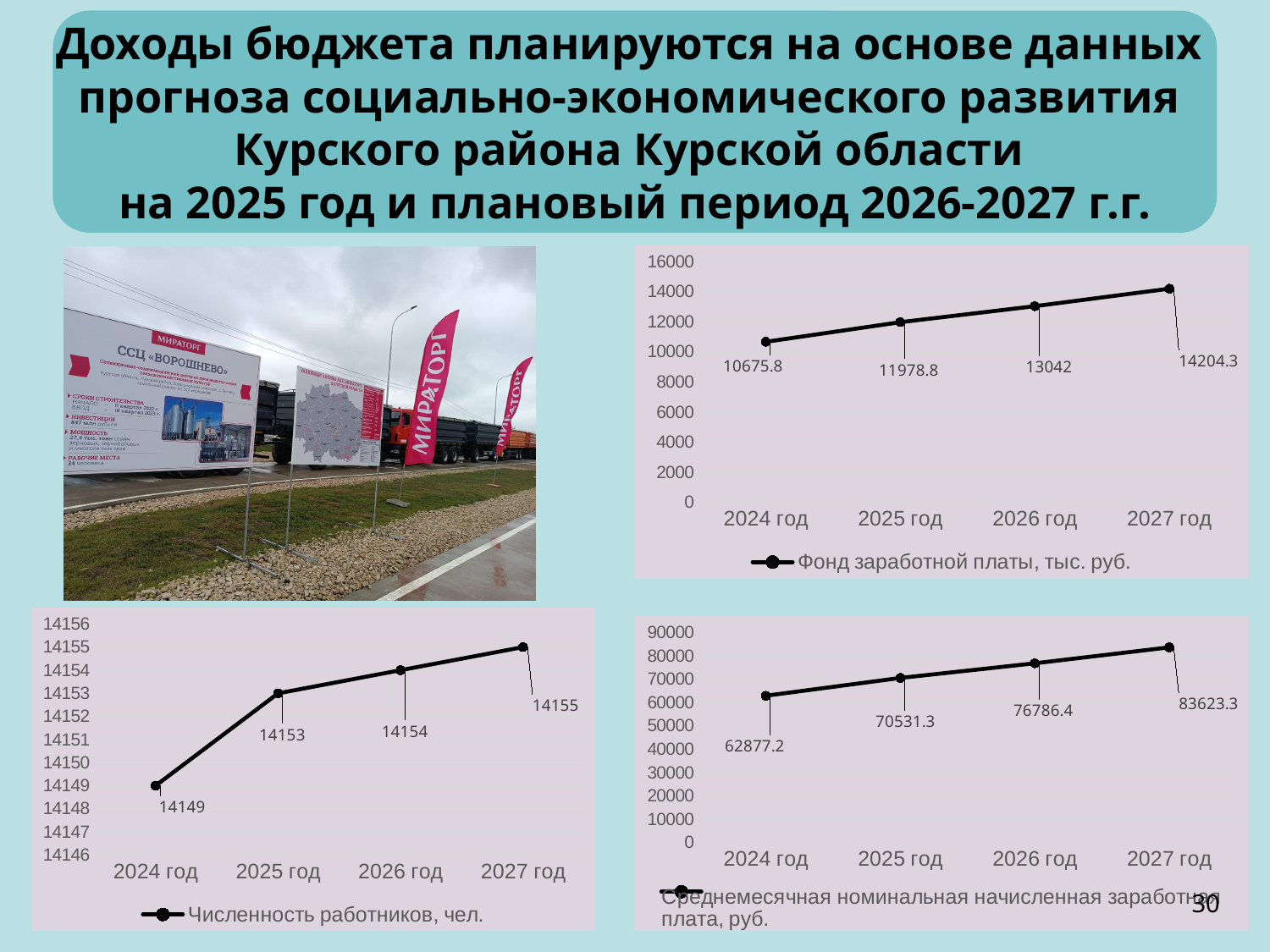
In the bottom-left chart (Численность работников, чел.), how many data points are plotted? 4 In the top-right chart (Фонд заработной платы, тыс. руб.), which year has the lowest value? 2024 год In the bottom-right chart (Среднемесячная номинальная начисленная заработная плата, руб.), what is the value for 2026 год? 76786.4 In the bottom-left chart (Численность работников, чел.), how much higher is the 2027 год value than the 2024 год value? 6 In the top-right chart (Фонд заработной платы, тыс. руб.), what is the value for 2024 год? 10675.8 In the top-right chart (Фонд заработной платы, тыс. руб.), what is the difference between the 2026 год and 2025 год values? 1063.2 In the bottom-right chart (Среднемесячная номинальная начисленная заработная плата, руб.), do the values rise or fall from 2024 год to 2027 год? rise In the bottom-left chart (Численность работников, чел.), what is the value for 2025 год? 14153 In the bottom-left chart (Численность работников, чел.), which year has the highest value? 2027 год In the top-right chart (Фонд заработной платы, тыс. руб.), what is the value for 2027 год? 14204.3 In the bottom-right chart (Среднемесячная номинальная начисленная заработная плата, руб.), which is larger: the value for 2024 год or 2025 год? 2025 год What type of chart is the top-right chart (Фонд заработной платы, тыс. руб.)? line chart